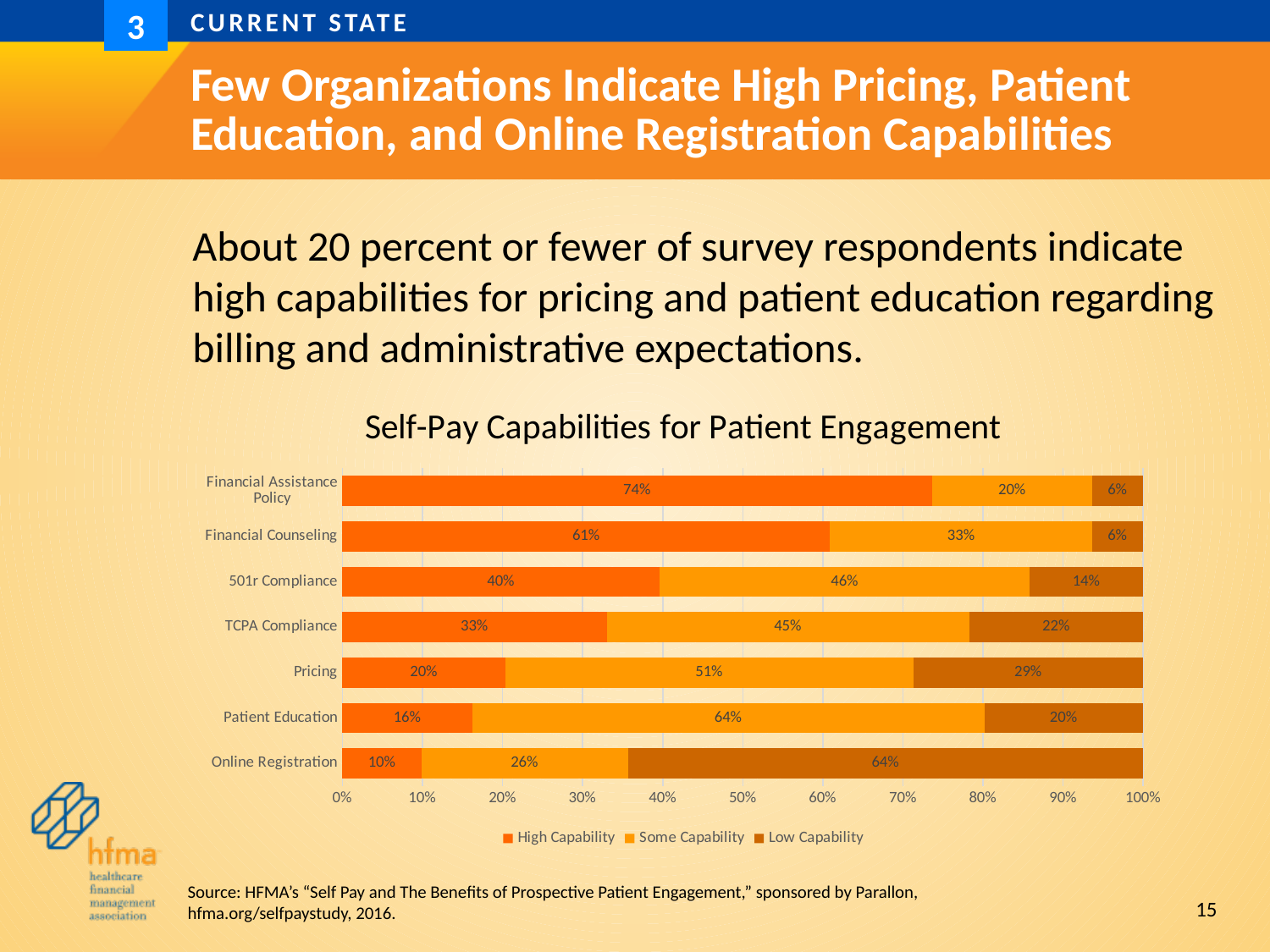
What is the Low Capability value for Online Registration? 64% What is the title of the chart? Self-Pay Capabilities for Patient Engagement Which is larger: the Low Capability value for TCPA Compliance or for Pricing? Pricing What is the total of the stacked bar for Patient Education? 100% Which category has the lowest High Capability value? Online Registration What kind of chart is shown on the slide? Stacked bar chart What is the difference between the High Capability values for Financial Counseling and 501r Compliance? 21% Which category has the highest High Capability value? Financial Assistance Policy What is the Some Capability value for Pricing? 51% What is the High Capability value for Financial Assistance Policy? 74% How many series does the legend list? 3 How many categories are shown on the chart? 7